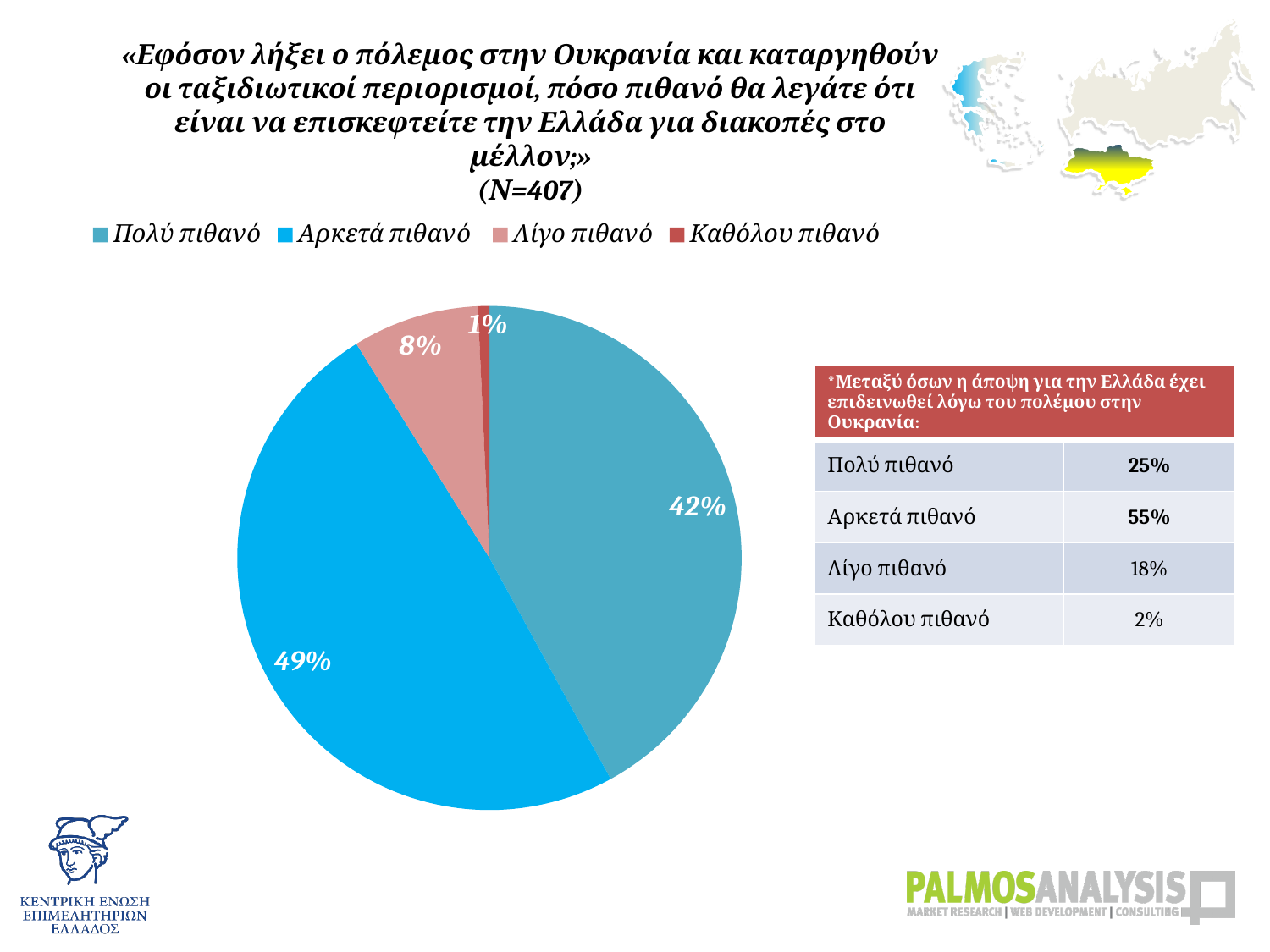
Which category has the largest slice of the pie? Αρκετά πιθανό What kind of chart is shown on the slide? Pie chart Which category has the smallest slice of the pie? Καθόλου πιθανό How many entries does the legend list? 4 What is the value shown for "Καθόλου πιθανό" in the pie chart? 1% What is the difference between the "Αρκετά πιθανό" and "Πολύ πιθανό" slices? 7% How many slices does the pie chart have? 4 Which is larger in the pie chart, "Λίγο πιθανό" or "Καθόλου πιθανό"? Λίγο πιθανό What sample size (N) is stated in the chart title? N=407 What is the value shown for "Λίγο πιθανό" in the pie chart? 8% What share of the pie does "Αρκετά πιθανό" have? 49% What share of the pie does "Πολύ πιθανό" have? 42%